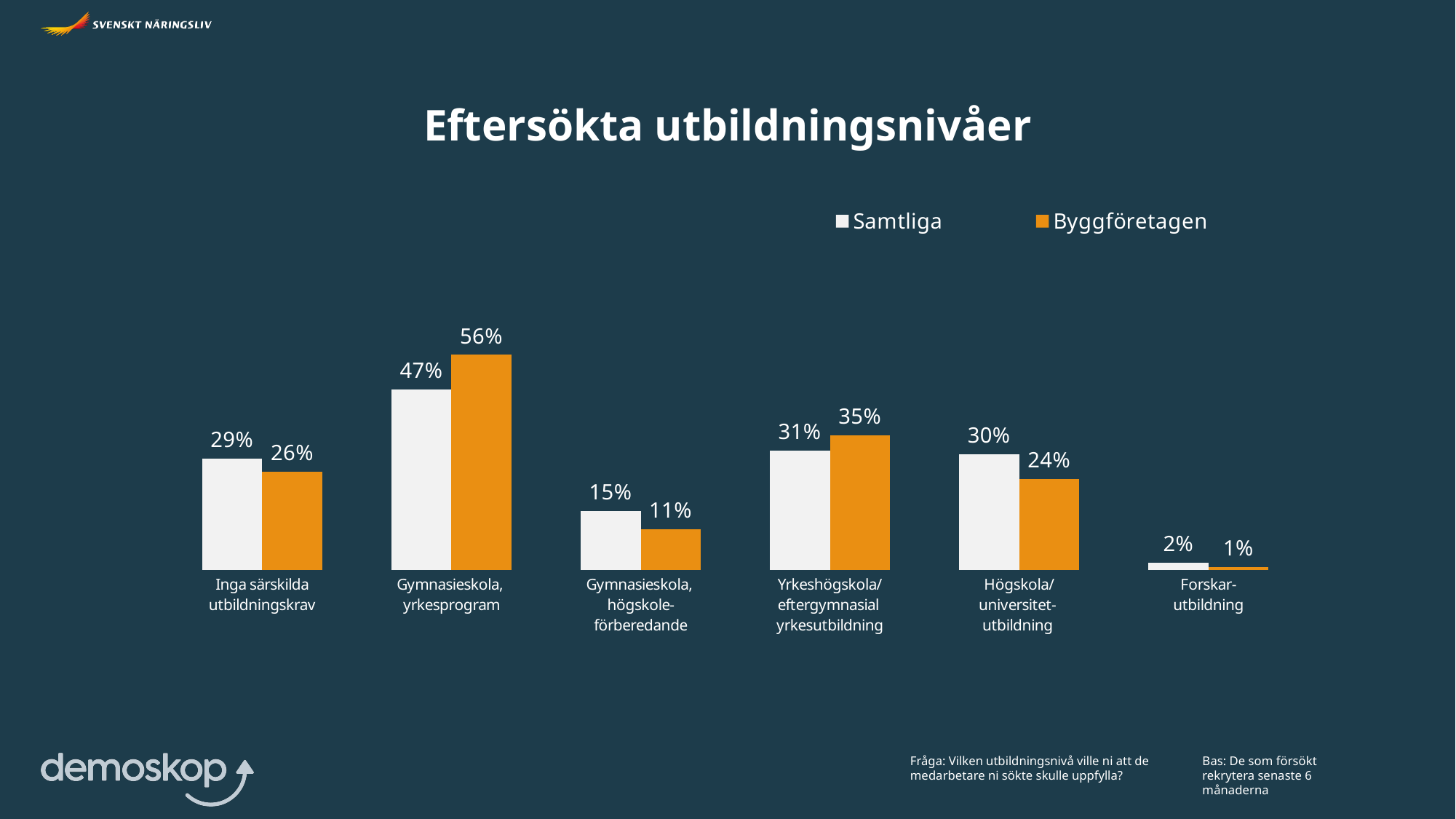
Which category has the highest Byggföretagen value? Gymnasieskola, yrkesprogram What is the Byggföretagen value for Forskarutbildning? 1% How many series does the legend list? 2 What is the difference between the Samtliga and Byggföretagen values for Gymnasieskola, högskoleförberedande? 4% What is the difference between the Byggföretagen and Samtliga values for Gymnasieskola, yrkesprogram? 9% For Yrkeshögskola/eftergymnasial yrkesutbildning, which series has the larger value, Samtliga or Byggföretagen? Byggföretagen What is the Byggföretagen value for Högskola/universitetutbildning? 24% What is the Samtliga value for Gymnasieskola, yrkesprogram? 47% How many categories are shown on the x axis? 6 Which category has the lowest Samtliga value? Forskarutbildning For Inga särskilda utbildningskrav, which series has the larger value, Samtliga or Byggföretagen? Samtliga What type of chart is shown on the slide? Bar chart